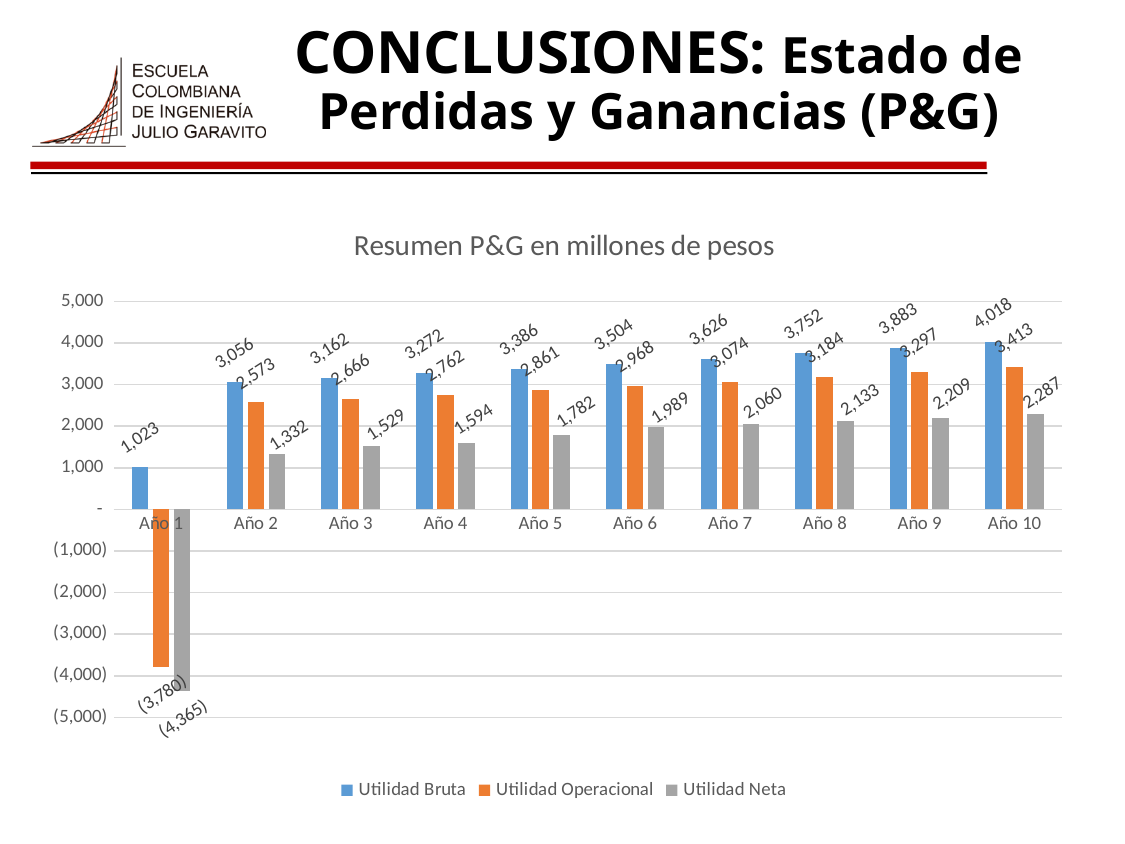
Which is larger in Año 3: Utilidad Operacional or Utilidad Neta? Utilidad Operacional What is the value of Utilidad Bruta in Año 10? 4,018 Does Utilidad Neta rise or fall from Año 2 to Año 10? Rise How many series does the legend list? 3 What is the title of the chart? Resumen P&G en millones de pesos What type of chart is shown on the slide? Bar chart What is the value of Utilidad Operacional in Año 5? 2,861 How many year categories are shown on the x axis? 10 What is the value of Utilidad Neta in Año 1? (4,365) In which year is Utilidad Neta lowest? Año 1 In which year is Utilidad Bruta highest? Año 10 What is the difference between Utilidad Bruta and Utilidad Neta in Año 7? 1,566